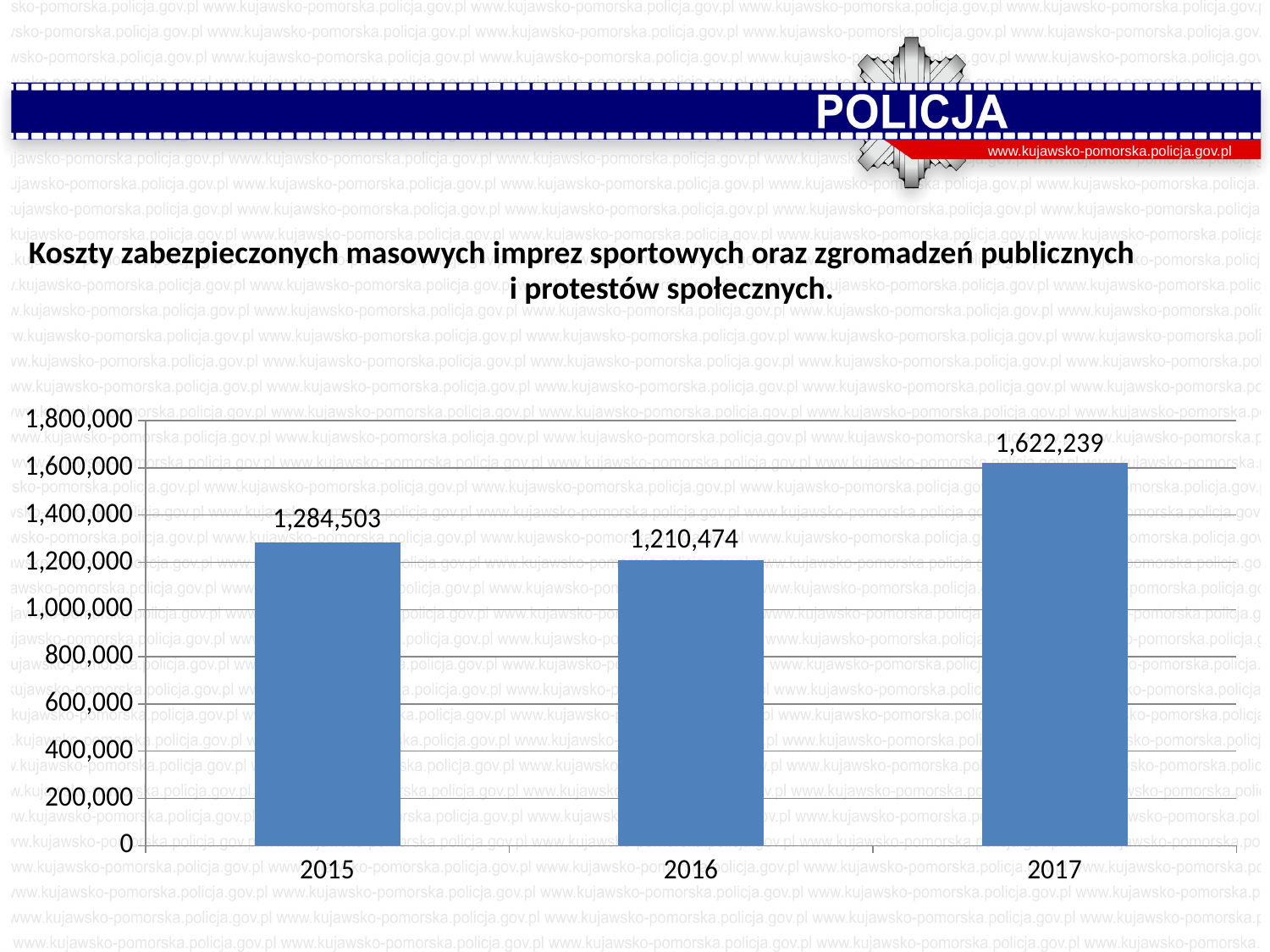
Which year has the lowest value? 2016 Which year has the highest value? 2017 Is the value for 2017 greater or less than 1,400,000? greater What is the value for 2017? 1,622,239 Which is larger, the value for 2015 or the value for 2016? 2015 Does the value rise or fall from 2016 to 2017? rise What is the difference between the values for 2017 and 2015? 337,736 What is the difference between the values for 2015 and 2016? 74,029 What is the value for 2016? 1,210,474 How many years are shown on the x axis? 3 What is the value for 2015? 1,284,503 What kind of chart is shown on the slide? bar chart